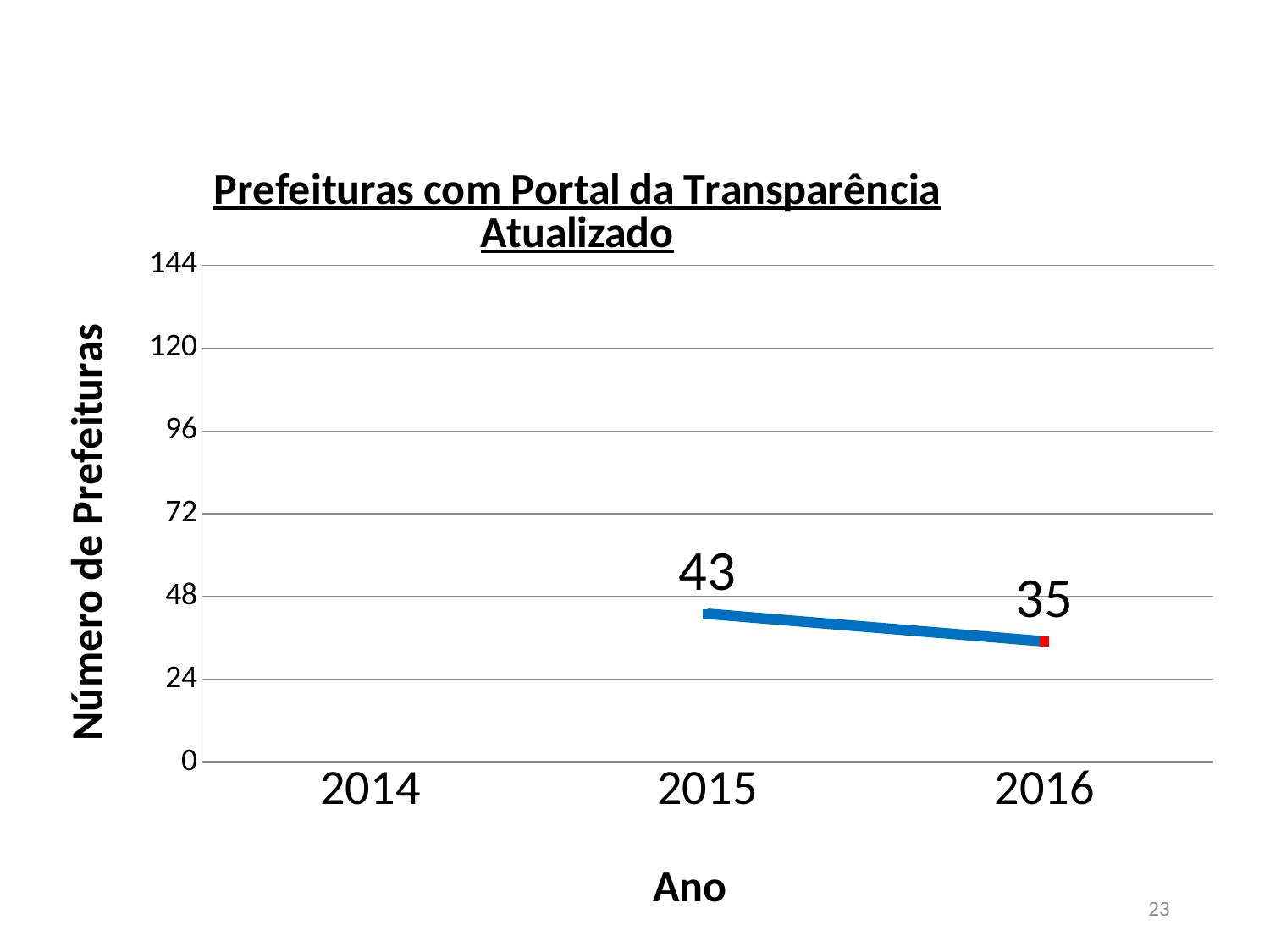
What is the value for 2016? 35 What is the title of the chart? Prefeituras com Portal da Transparência Atualizado Which is larger, the value for 2015 or the value for 2016? 2015 What is the value for 2015? 43 Which year has the highest value? 2015 What is the difference between the values for 2015 and 2016? 8 Do the values rise or fall from 2015 to 2016? fall Is the value for 2016 greater or less than 24? greater Is the value for 2015 greater or less than 48? less Which year has the lowest plotted value? 2016 What kind of chart is this? line chart How many years are shown on the x axis? 3